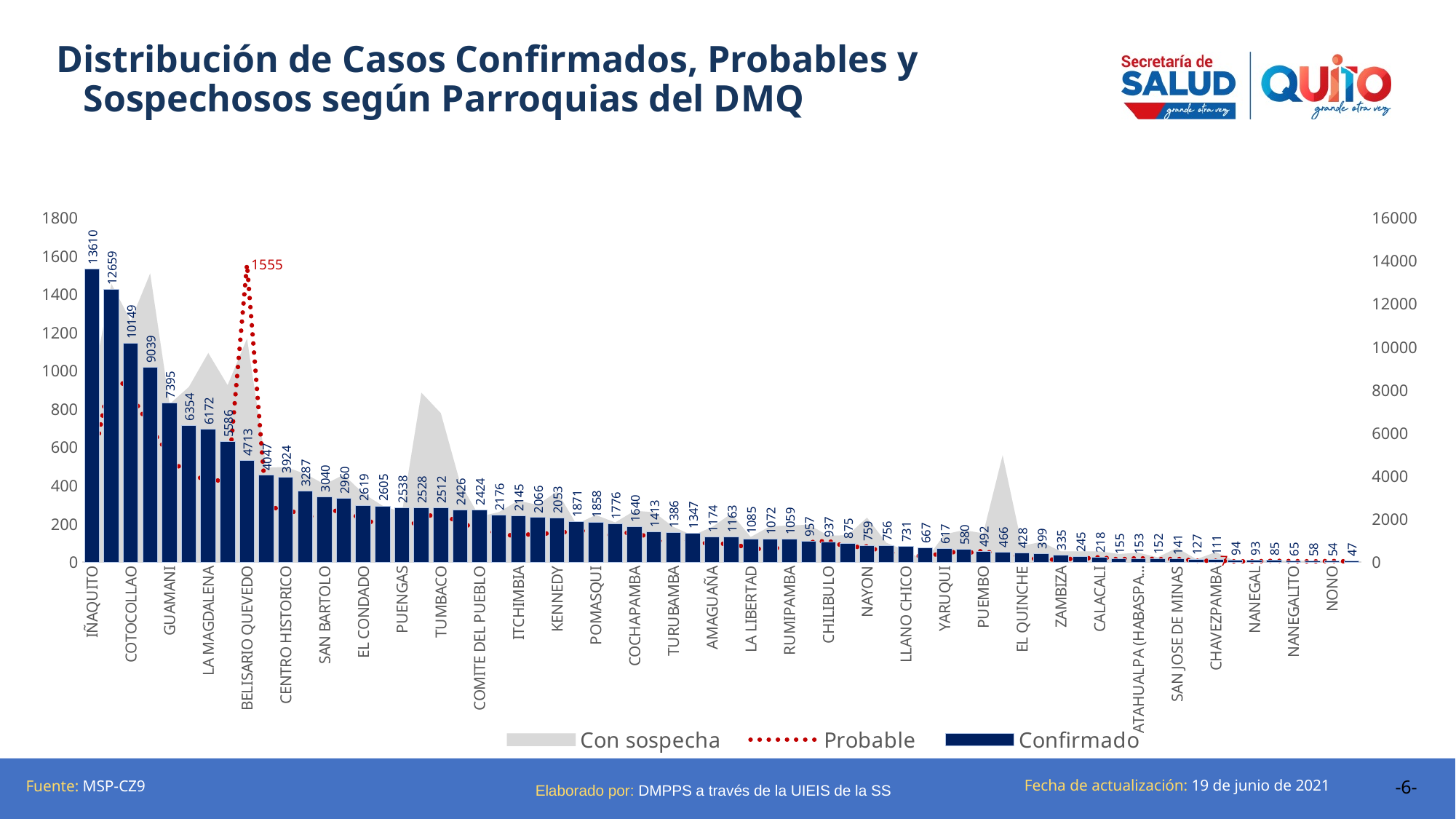
How many series does the legend list? 3 What kind of chart is shown on the slide? Bar chart combined with a dotted line and an area series What is the difference between the Confirmado values for IÑAQUITO and COTOCOLLAO? 3461 Which has more confirmed cases, GUAMANI or LA MAGDALENA? GUAMANI What is the Confirmado value for IÑAQUITO? 13610 What is the Confirmado value for COTOCOLLAO? 10149 Is the Probable value for IÑAQUITO greater or less than 400 on the left axis? greater What is the peak value labelled on the Probable dotted line? 1555 What is the smallest Confirmado value printed on the chart? 47 Do the Confirmado bars rise or fall from left to right along the x axis? Fall What is the Confirmado value for TUMBACO? 2512 Which parroquia has the highest number of confirmed cases (Confirmado)? IÑAQUITO